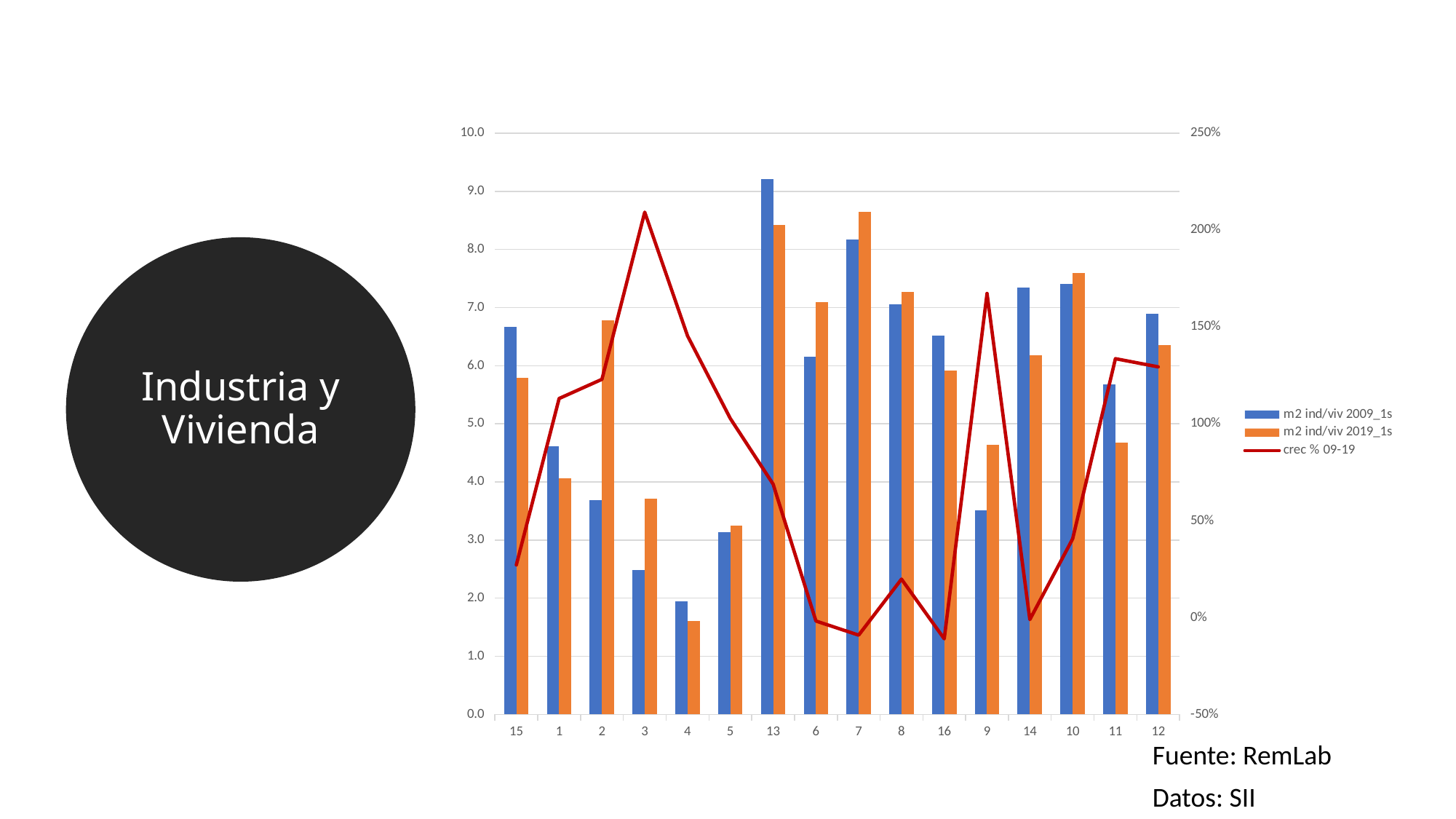
Which category has the highest value for m2 ind/viv 2009_1s? 13 Is the value for m2 ind/viv 2019_1s in category 4 greater or less than 2.0? less How many categories are shown on the x axis? 16 How many series does the legend list? 3 Which category has the highest value for crec % 09-19? 3 Which category has the lowest value for m2 ind/viv 2019_1s? 4 In category 15, which is larger: m2 ind/viv 2009_1s or m2 ind/viv 2019_1s? m2 ind/viv 2009_1s Is the value for crec % 09-19 in category 14 greater or less than 50%? less In category 2, which is larger: m2 ind/viv 2009_1s or m2 ind/viv 2019_1s? m2 ind/viv 2019_1s What kind of chart is this? Bar chart with a line What colour is the crec % 09-19 line? Red Is the value for m2 ind/viv 2009_1s in category 13 greater or less than 9.0? greater